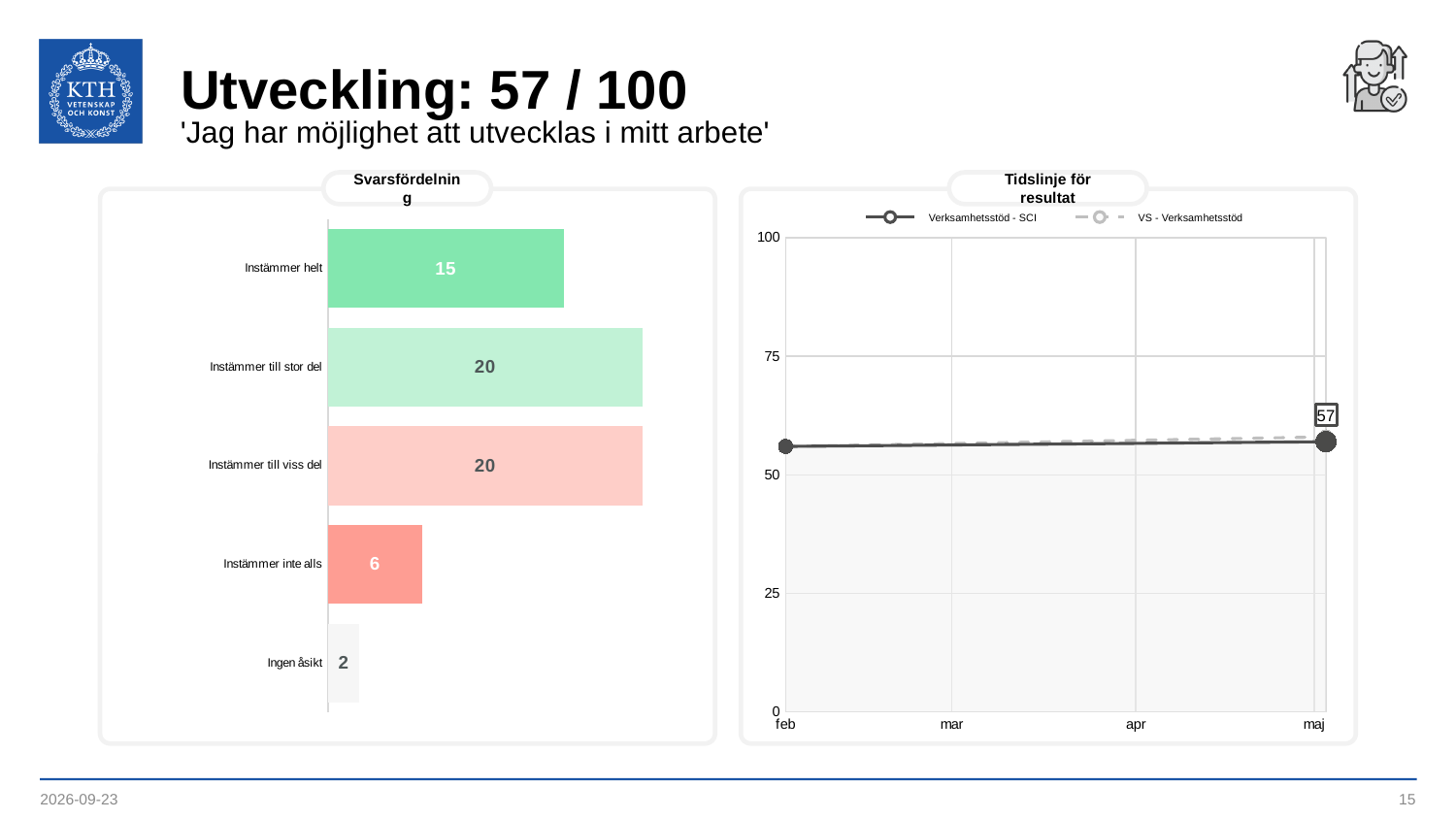
In the Svarsfördelning chart, what is the value for 'Instämmer helt'? 15 In the Svarsfördelning chart, what is the value for 'Instämmer inte alls'? 6 In the Svarsfördelning chart, which category has the lowest value? Ingen åsikt What kind of chart is the Svarsfördelning chart? Bar chart How many series does the legend of the Tidslinje för resultat chart list? 2 In the Svarsfördelning chart, what is the difference between 'Instämmer till stor del' and 'Instämmer inte alls'? 14 How many categories does the Svarsfördelning chart show? 5 In the Tidslinje för resultat chart, is the value for Verksamhetsstöd - SCI in feb greater or less than 75? less In the Svarsfördelning chart, which is larger: 'Instämmer helt' or 'Instämmer till viss del'? Instämmer till viss del In the Tidslinje för resultat chart, what is the value for Verksamhetsstöd - SCI in maj? 57 What kind of chart is the Tidslinje för resultat chart? Line chart In the Svarsfördelning chart, what is the value for 'Ingen åsikt'? 2